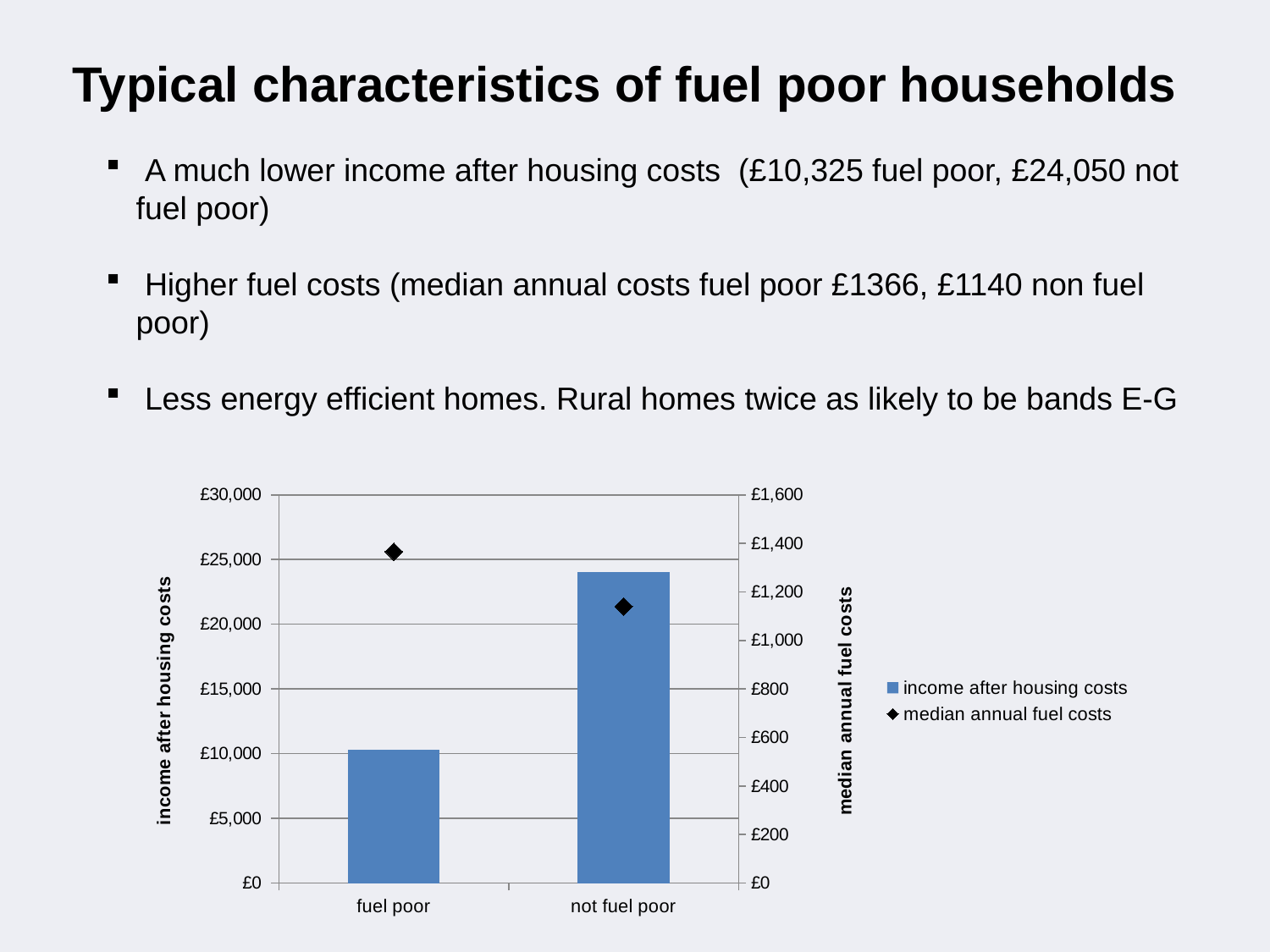
Which category has the higher income after housing costs bar? not fuel poor Is the median annual fuel costs value for not fuel poor greater or less than £1,000? greater Which series is plotted as diamond markers in the chart? median annual fuel costs How many categories are shown on the x axis of the chart? 2 What kind of chart is shown on the slide? bar chart Is the income after housing costs for not fuel poor greater or less than £20,000? greater How many series does the chart legend list? 2 Which category has the higher median annual fuel costs marker? fuel poor What is the label of the left vertical axis of the chart? income after housing costs Is the median annual fuel costs value for fuel poor greater or less than £1,200? greater Which category has the lower income after housing costs bar? fuel poor